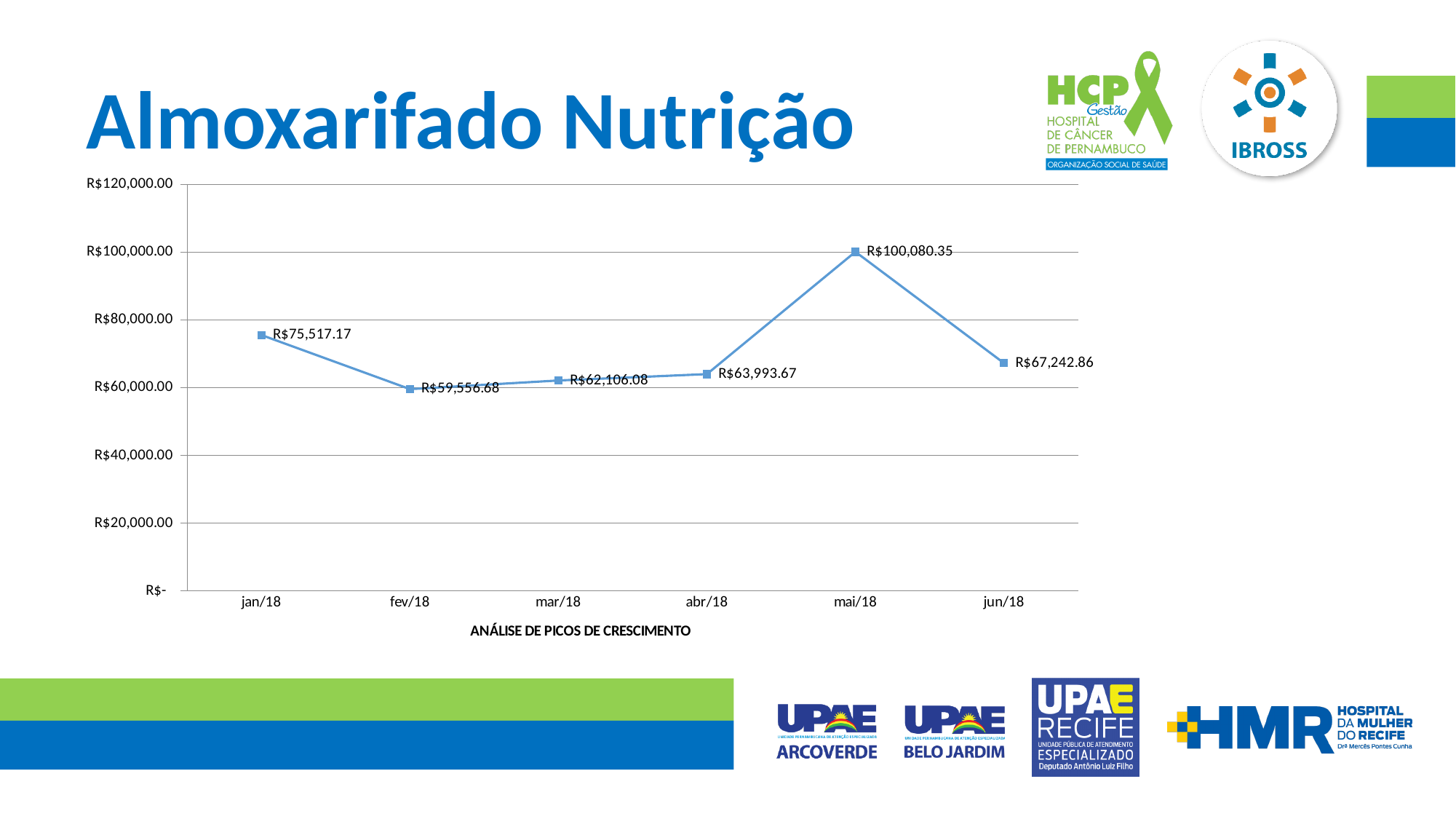
What is the value for fev/18? R$59,556.68 What is the difference between the values for jan/18 and fev/18? R$15,960.49 Which month has the lowest value? fev/18 Which is larger, the value for jan/18 or the value for jun/18? jan/18 What is the value for mai/18? R$100,080.35 Which month has the highest value? mai/18 Does the value rise or fall from abr/18 to mai/18? rise What kind of chart is shown on the slide? line chart What is the difference between the values for mai/18 and abr/18? R$36,086.68 How many months are plotted on the chart? 6 What is the value for jun/18? R$67,242.86 Is the value for mai/18 greater or less than R$80,000.00? greater